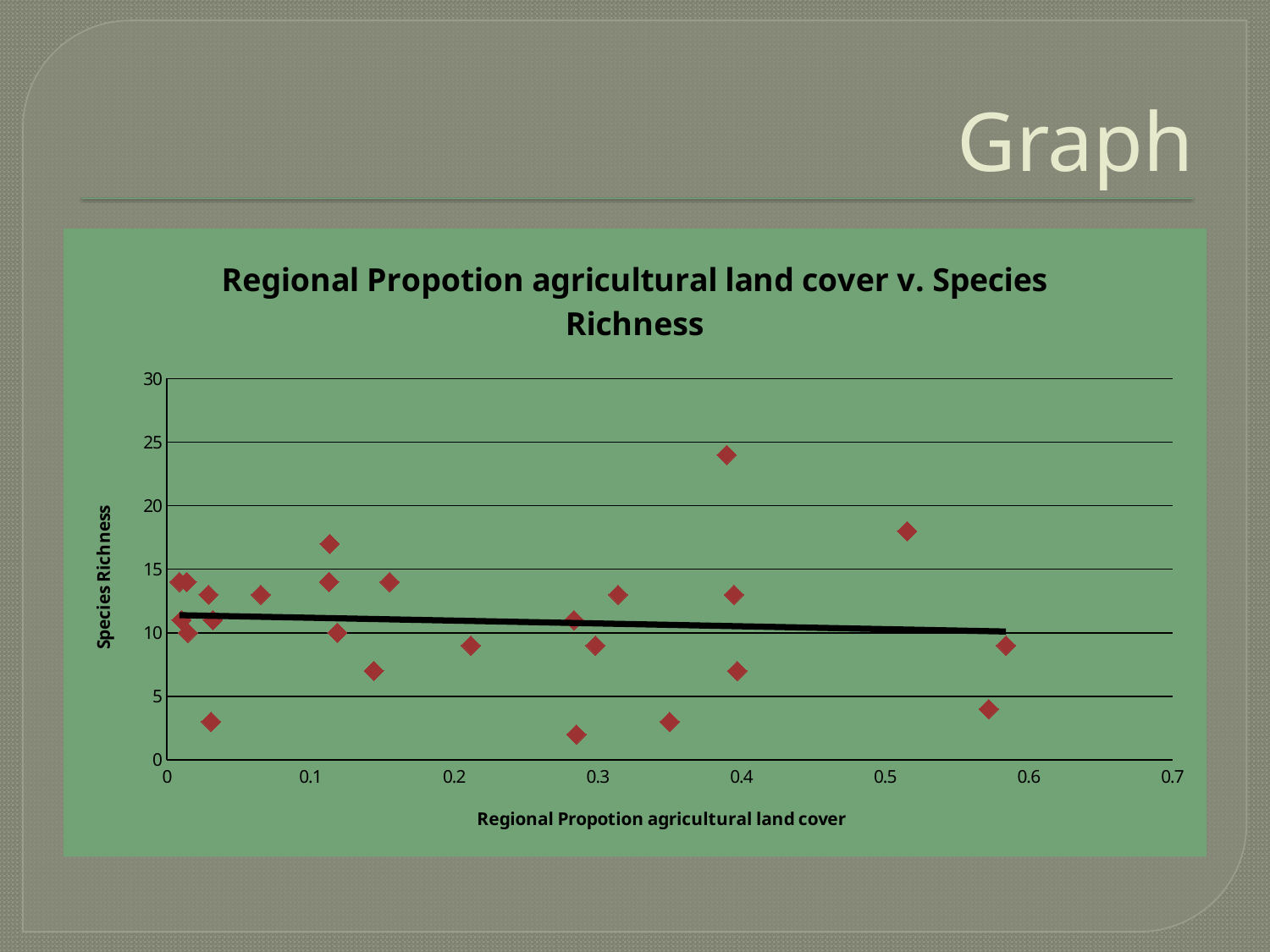
What is the label on the vertical axis of the chart? Species Richness What is the title of the chart? Regional Propotion agricultural land cover v. Species Richness Is the species richness of the point near 0.35 on the x axis greater or less than 5? less Is the species richness of the point furthest to the right on the chart greater or less than 10? less Is the species richness of the point near 0.5 on the x axis greater or less than 15? greater Does the trend line in the chart rise or fall as the regional proportion of agricultural land cover increases? fall What kind of chart is shown on the slide? scatter chart Which has the higher species richness: the highest point near 0.4 on the x axis or the point near 0.5 on the x axis? the point near 0.4